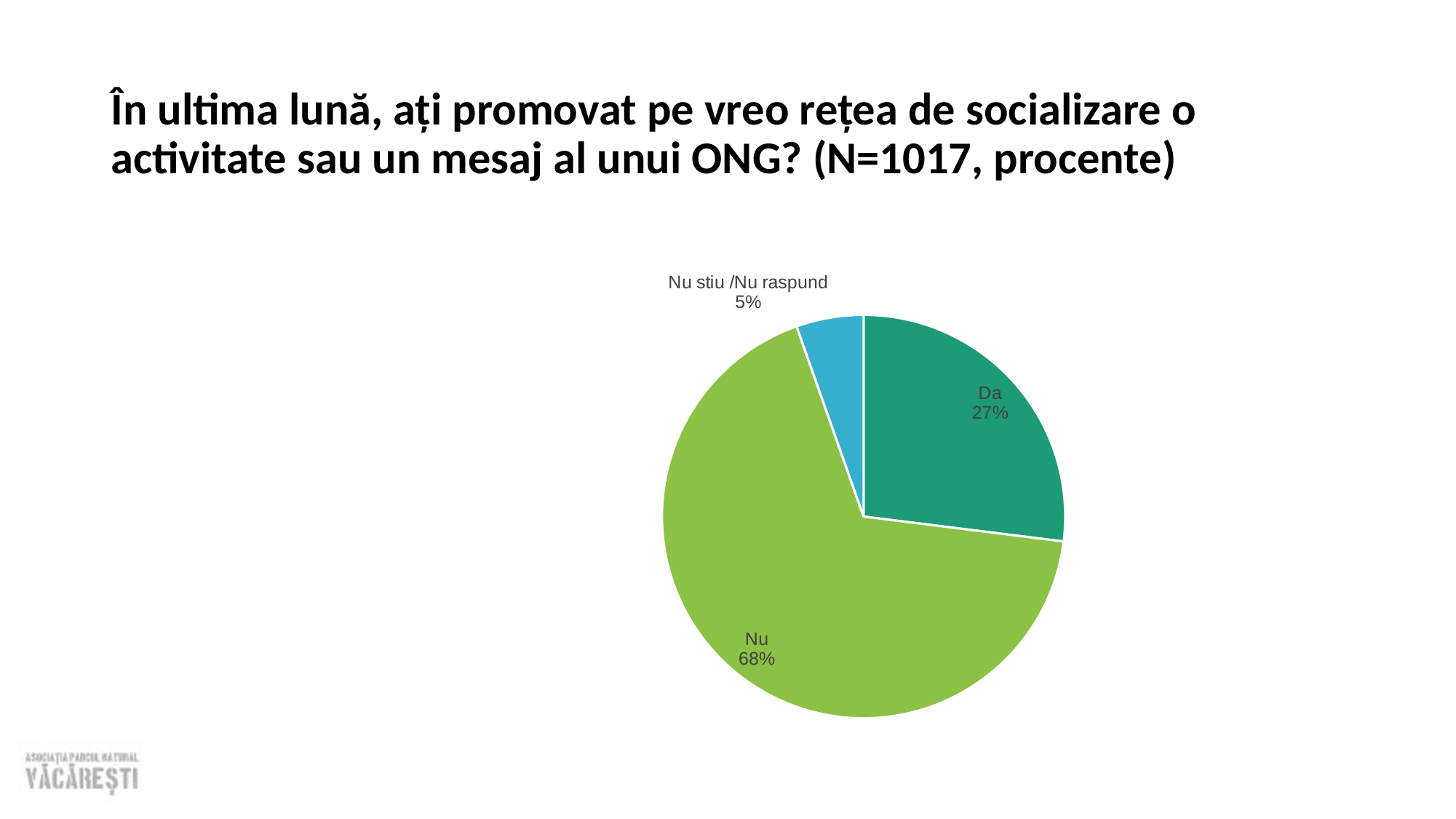
What percentage of respondents answered "Da"? 27% What is the difference in percentage points between "Da" and "Nu stiu /Nu raspund"? 22 What is the sample size (N) stated in the slide title? 1017 Which response has the smallest share of the pie? Nu stiu /Nu raspund What colour is the "Nu" slice of the pie? green What percentage of respondents answered "Nu stiu /Nu raspund"? 5% What is the difference in percentage points between "Nu" and "Da"? 41 Which is larger, the share for "Da" or the share for "Nu stiu /Nu raspund"? Da What percentage of respondents answered "Nu"? 68% Which response has the largest share of the pie? Nu How many slices does the pie chart have? 3 What kind of chart is shown on the slide? pie chart